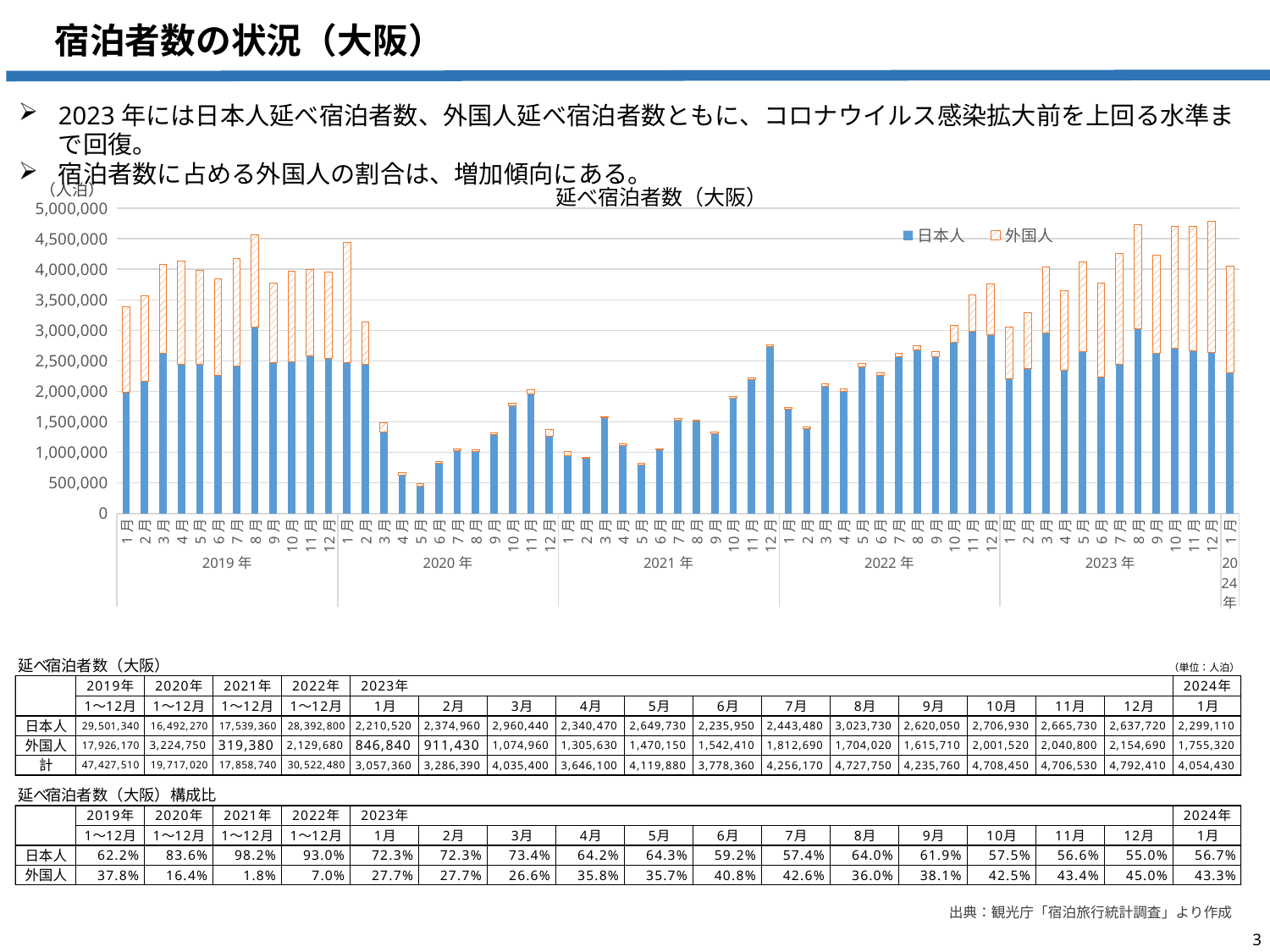
Which month of 2023 has the highest total (計) 延べ宿泊者数（大阪）? 12月 What kind of chart is 延べ宿泊者数（大阪）? bar chart What is the 計 value for 2022年 1〜12月 in the 延べ宿泊者数（大阪） table? 30,522,480 What is the 日本人 value for 2023年8月 in the 延べ宿泊者数（大阪） table? 3,023,730 What is the difference between the 日本人 and 外国人 values for 2023年1月 in the 延べ宿泊者数（大阪） table? 1,363,680 Which is larger, the 日本人 value for 2023年3月 or for 2023年4月? 2023年3月 Which month of 2023 has the lowest total (計) 延べ宿泊者数（大阪）? 1月 How many series does the legend of the 延べ宿泊者数（大阪） chart list? 2 What is the total (計) of 延べ宿泊者数（大阪） for 2023年12月? 4,792,410 What are the two legend entries in the 延べ宿泊者数（大阪） chart? 日本人, 外国人 In the 延べ宿泊者数（大阪） chart, is the total bar for 2020年4月 greater or less than 1,000,000? less What is the 外国人 value for 2024年1月 in the 延べ宿泊者数（大阪） table? 1,755,320